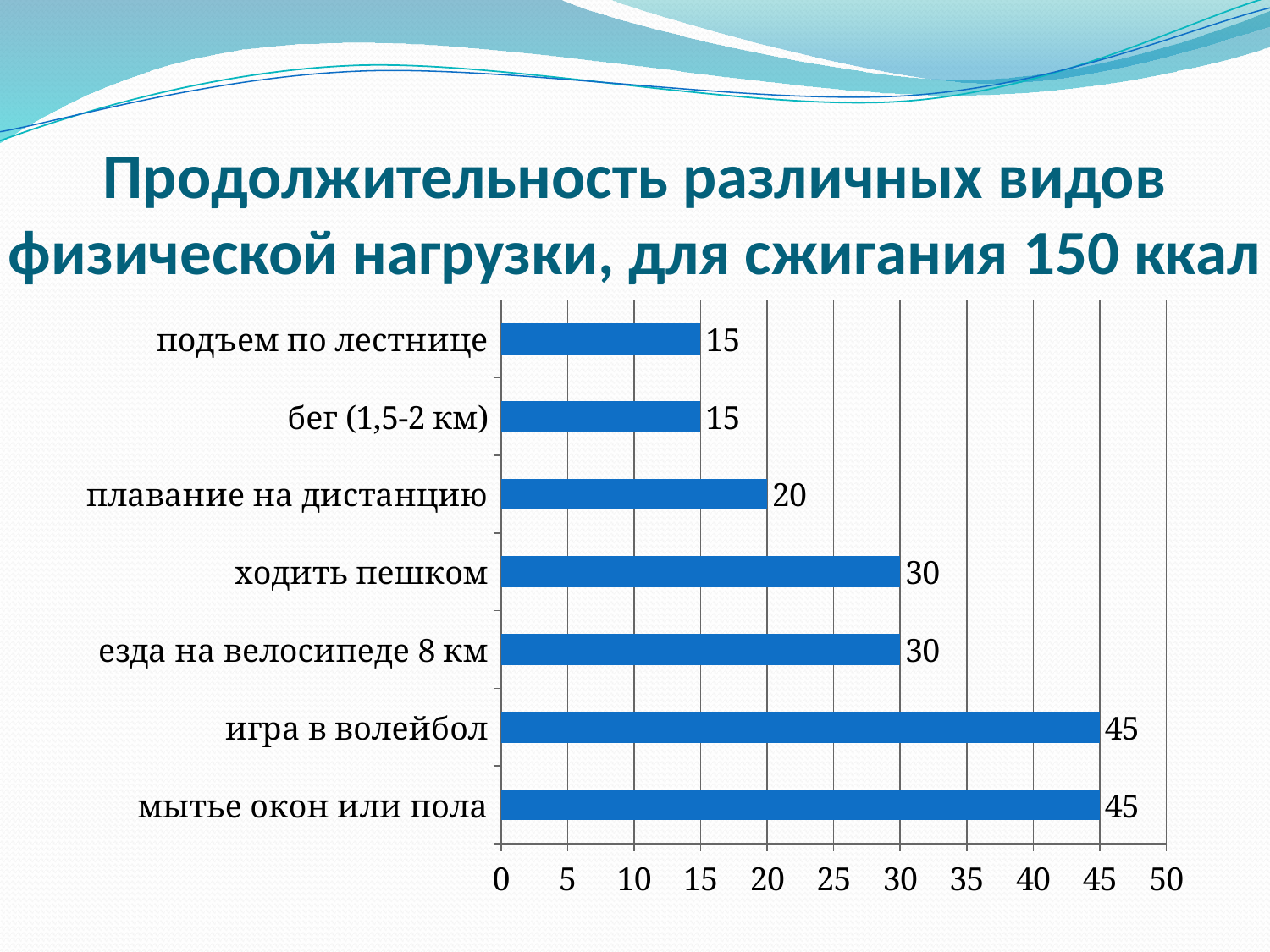
What is the maximum value shown on the horizontal axis? 50 What is the value for плавание на дистанцию? 20 What is the difference between the values for езда на велосипеде 8 км and плавание на дистанцию? 10 What is the difference between the values for мытье окон или пола and подъем по лестнице? 30 What is the value for подъем по лестнице? 15 What kind of chart is shown on the slide? bar chart Is the value for ходить пешком greater or less than плавание на дистанцию? greater What is the value for ходить пешком? 30 What is the value for игра в волейбол? 45 Which category has the lowest value, плавание на дистанцию or бег (1,5-2 км)? бег (1,5-2 км) What is the title of the slide? Продолжительность различных видов физической нагрузки, для сжигания 150 ккал How many categories are shown in the chart? 7